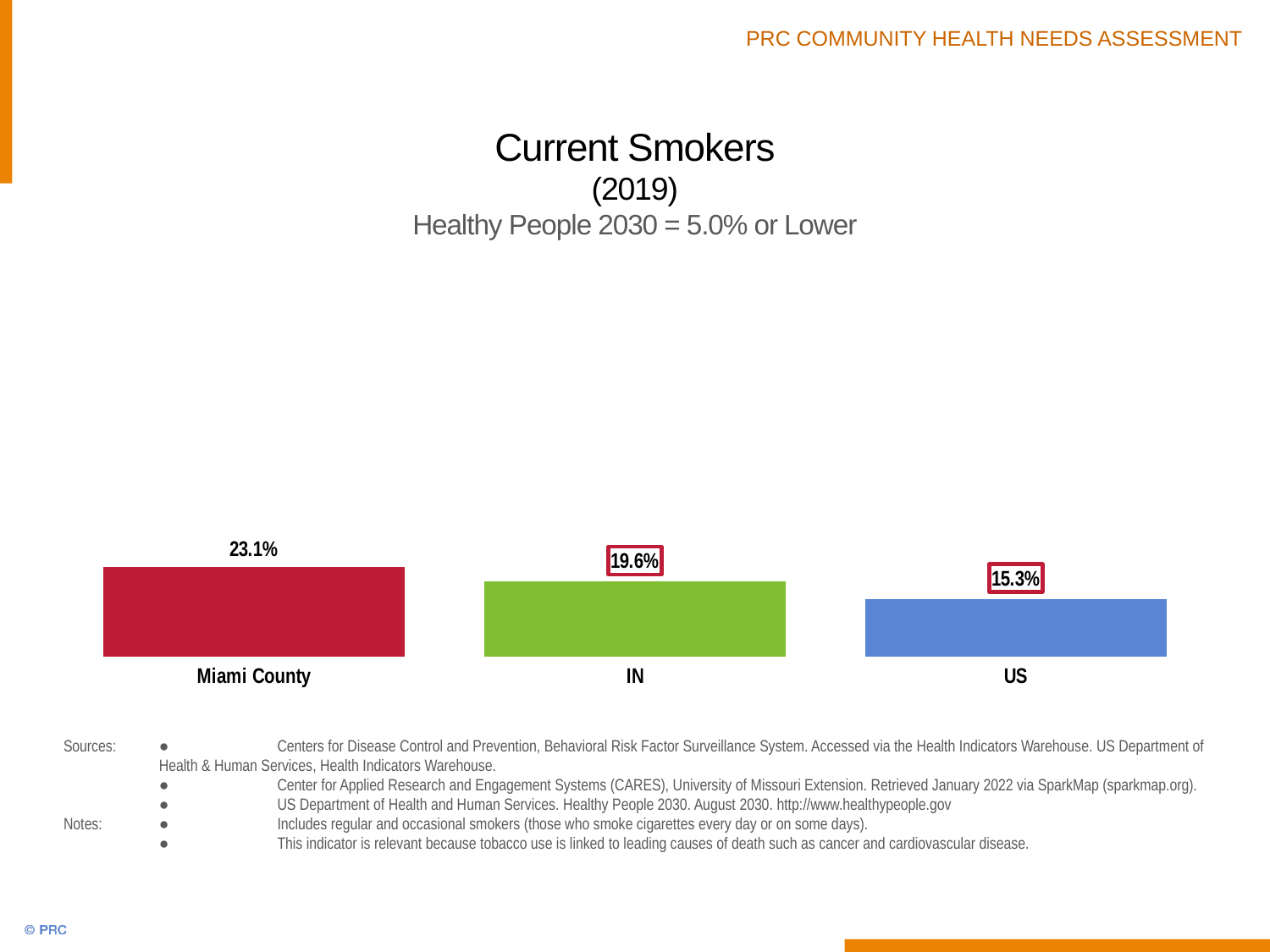
What is the value for IN in the Current Smokers chart? 19.6% What is the value for US in the Current Smokers chart? 15.3% Which category has the highest value in the Current Smokers chart? Miami County What Healthy People 2030 target is stated in the chart's subtitle? 5.0% or Lower How many categories are shown in the Current Smokers chart? 3 What is the difference between the Miami County and US values in the Current Smokers chart? 7.8% What kind of chart is shown on the slide? Bar chart What is the difference between the Miami County and IN values in the Current Smokers chart? 3.5% Which category has the lowest value in the Current Smokers chart? US Which is larger in the Current Smokers chart, the value for IN or the value for US? IN What is the value for Miami County in the Current Smokers chart? 23.1% Do the values rise or fall from left to right across the Current Smokers chart? Fall